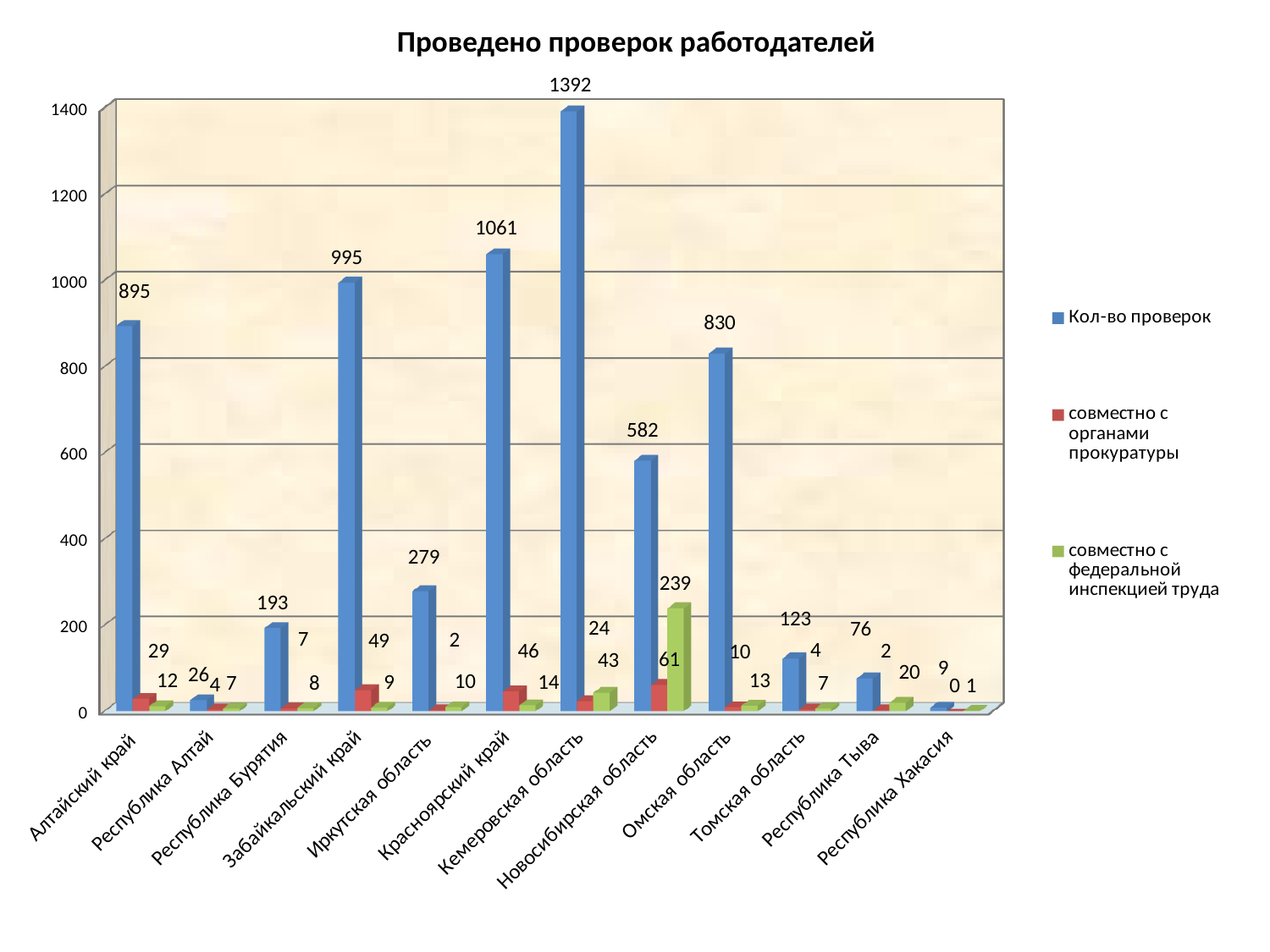
What is the value of Кол-во проверок for Забайкальский край? 995 How many regions are shown on the x axis? 12 What is the value of совместно с федеральной инспекцией труда for Новосибирская область? 239 What is the title of the chart? Проведено проверок работодателей What is the difference between Кол-во проверок for Кемеровская область and Красноярский край? 331 What is the value of Кол-во проверок for Кемеровская область? 1392 What kind of chart is shown on the slide? Bar chart Which region has the lowest value of Кол-во проверок? Республика Хакасия How many series does the legend list? 3 What is the value of совместно с органами прокуратуры for Красноярский край? 46 Which is larger: Кол-во проверок for Алтайский край or for Омская область? Алтайский край Which region has the highest value of Кол-во проверок? Кемеровская область